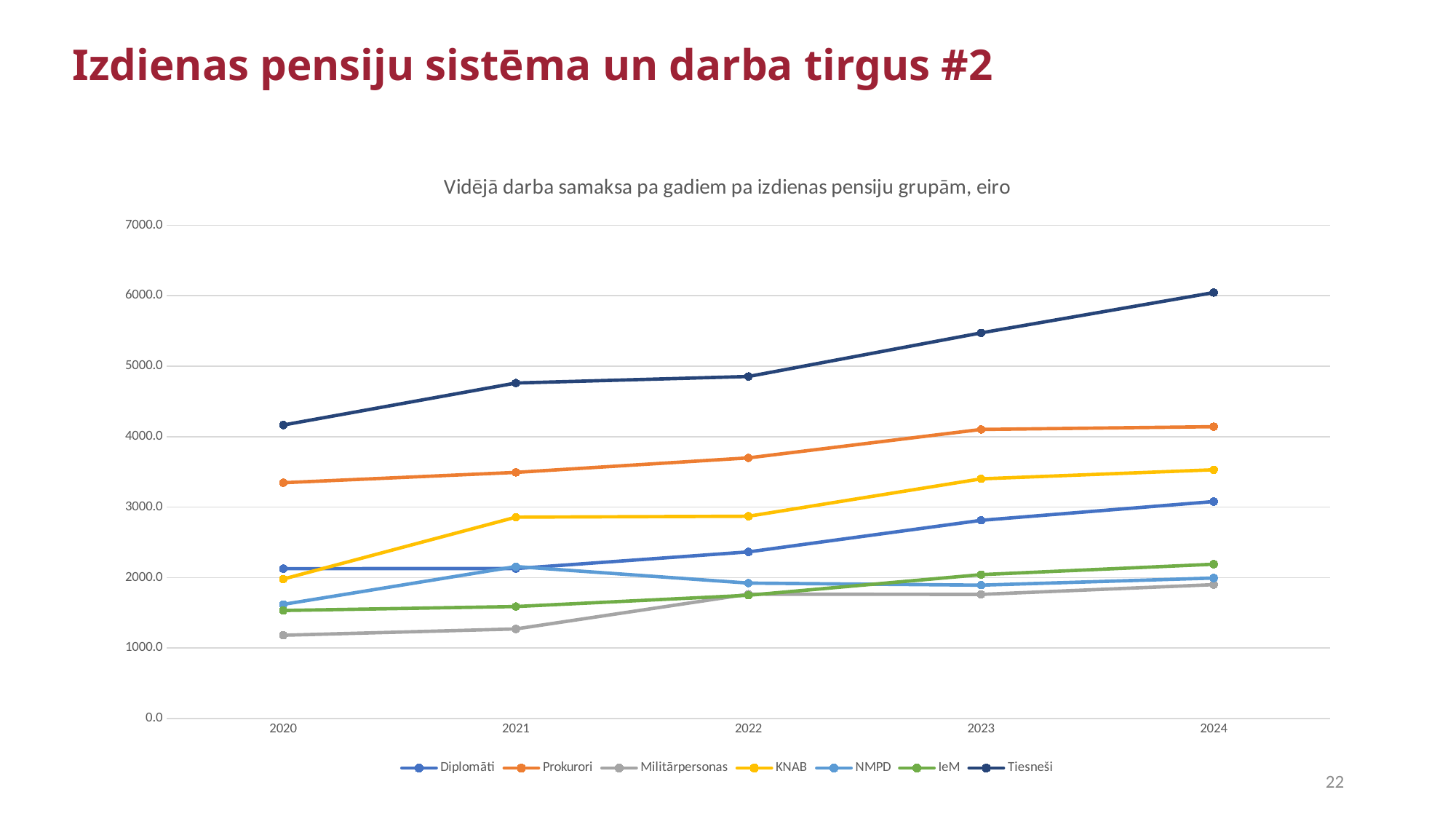
How many years are shown on the x axis? 5 Does the Tiesneši line rise or fall from 2020 to 2024? rises Which group has the lowest average pay in 2020? Militārpersonas In 2024, which is higher: Prokurori or KNAB? Prokurori Which group has the highest average pay in 2024? Tiesneši Is the value for KNAB in 2023 greater or less than 3000.0? greater What is the title of the chart? Vidējā darba samaksa pa gadiem pa izdienas pensiju grupām, eiro How many series does the legend list? 7 Is the value for Militārpersonas in 2020 greater or less than 2000.0? less What kind of chart is shown on the slide? line chart In 2020, which is higher: Diplomāti or NMPD? Diplomāti Is the value for Tiesneši in 2024 greater or less than 5000.0? greater